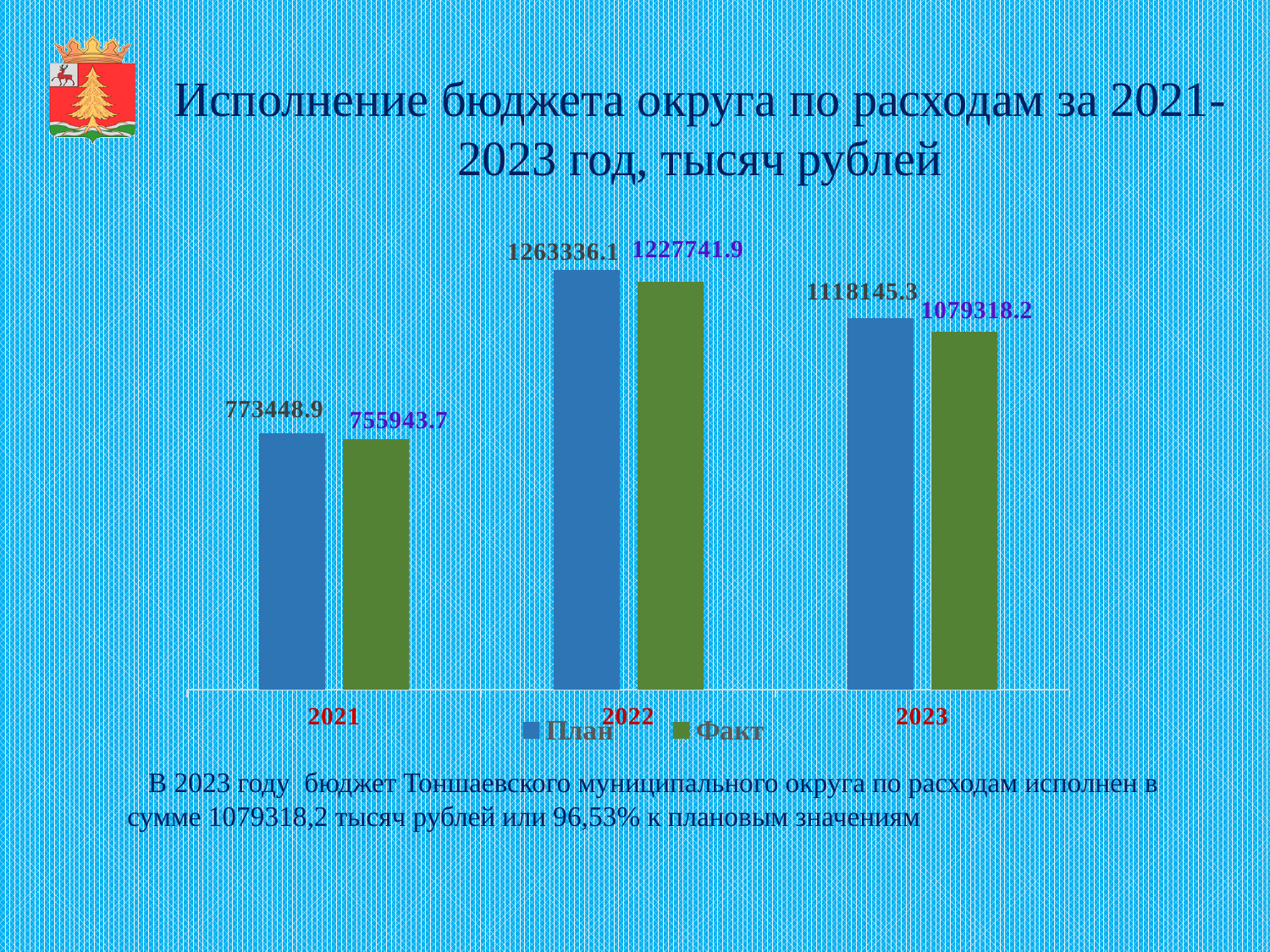
What is the Факт value for 2021? 755943.7 What is the difference between the План and Факт values for 2021? 17505.2 What is the difference between the План and Факт values for 2023? 38827.1 How many years are shown on the x axis? 3 What is the Факт value for 2023? 1079318.2 What is the План value for 2022? 1263336.1 What kind of chart is shown on the slide? Bar chart What is the План value for 2023? 1118145.3 How many series does the legend list? 2 In which year is the Факт value highest? 2022 In which year is the План value lowest? 2021 Which is larger for 2022, the План value or the Факт value? План